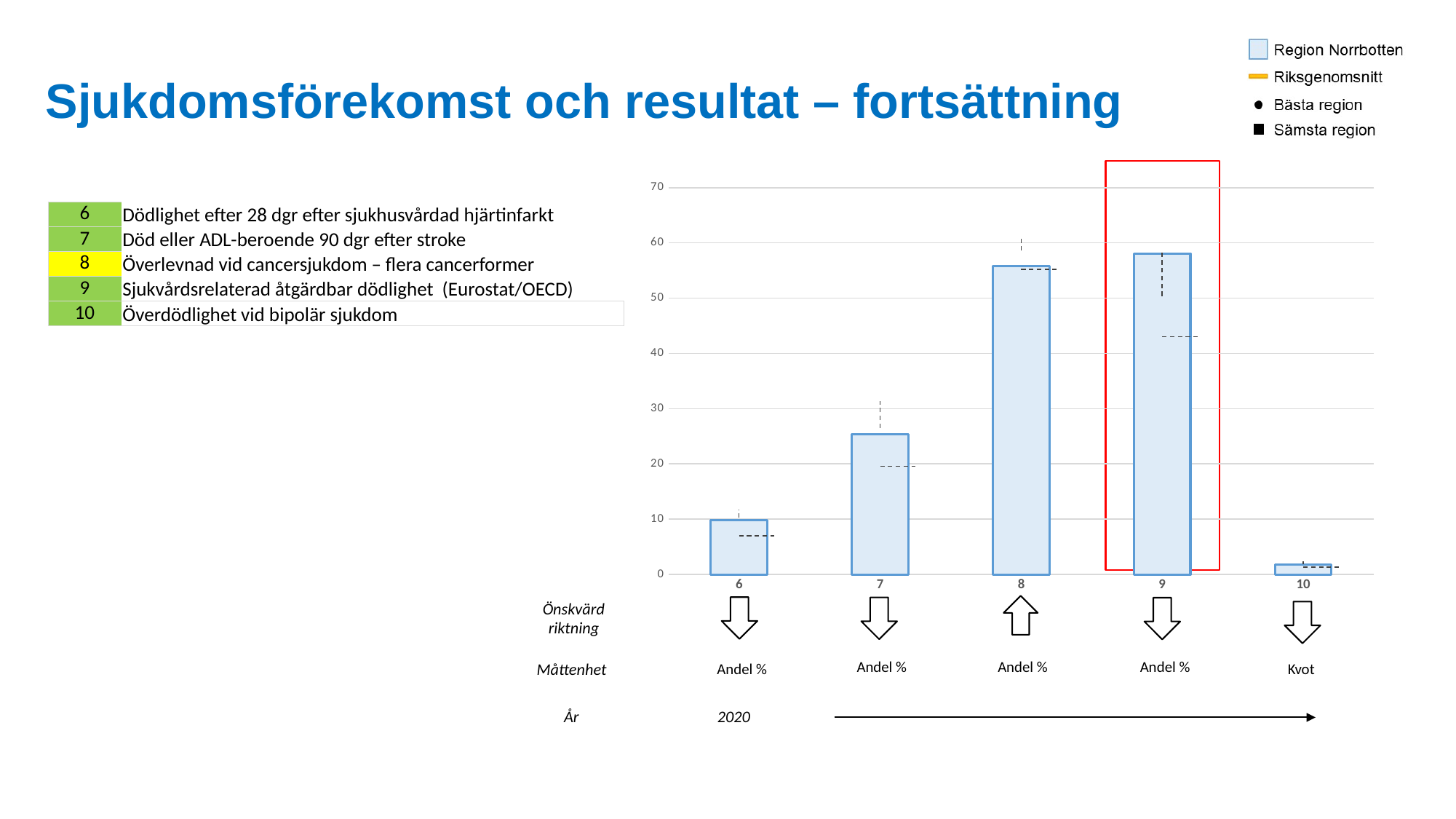
What kind of chart is shown on the slide? bar chart Is the value for category 8 greater or less than 50? greater How many categories are plotted on the x axis of the chart? 5 Which legend entry is represented by the light blue bars? Region Norrbotten Which category has the lowest bar in the chart? 10 Which has the larger bar, category 9 or category 10? 9 Which has the larger bar, category 6 or category 7? 7 Is the value for category 7 greater or less than 20? greater How many entries does the chart legend list? 4 Is the value for category 7 greater or less than 30? less